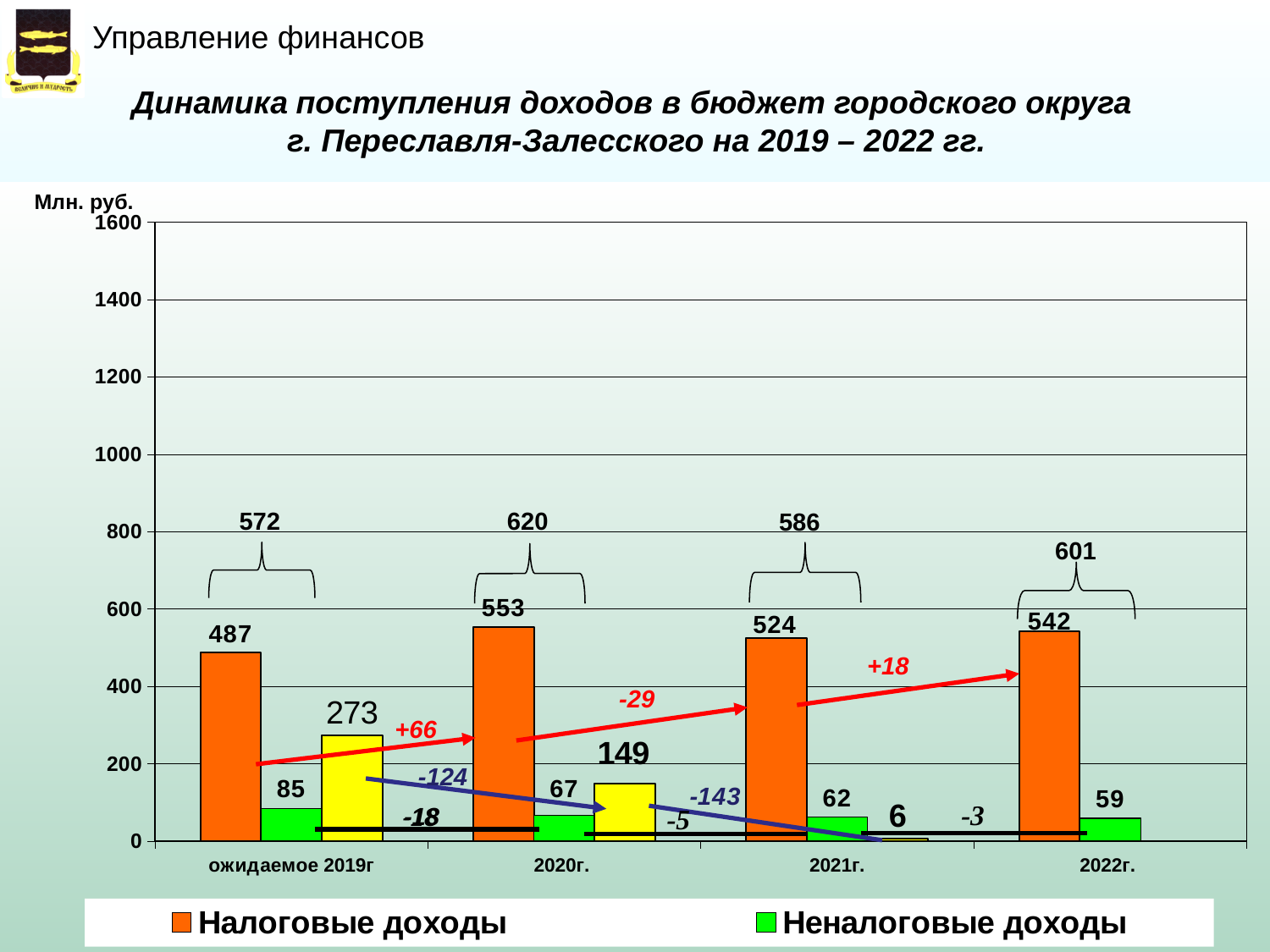
How many series does the legend list? 2 What is the value of Налоговые доходы for 2022г.? 542 In which year is Налоговые доходы highest? 2020г. What is the value of Налоговые доходы for 2020г.? 553 What kind of chart is shown on the slide? bar chart What is the difference between Налоговые доходы in 2020г. and in ожидаемое 2019г? 66 How many year categories are shown on the x axis? 4 Is the value of Налоговые доходы for ожидаемое 2019г greater or less than 400? greater Which is larger: Налоговые доходы in 2021г. or in 2022г.? 2022г. What is the combined total shown above the bracket for 2021г.? 586 What is the value of Неналоговые доходы for ожидаемое 2019г? 85 In which year is Неналоговые доходы lowest? 2022г.